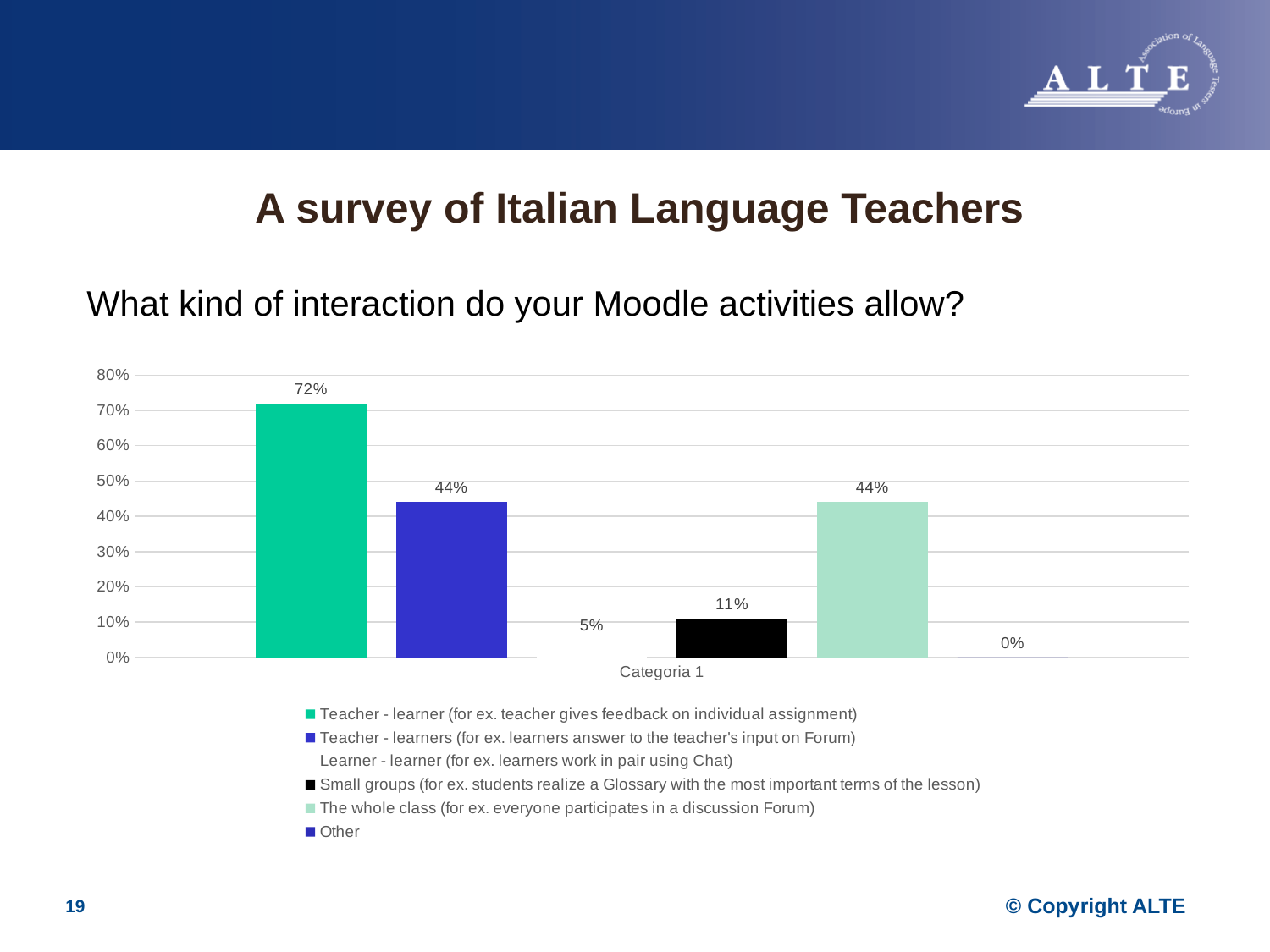
What value is shown for "Small groups"? 11% Which type of interaction has the highest percentage? Teacher - learner What is the difference between the "Teacher - learner" value and the "Teacher - learners" value? 28% What kind of chart is shown on the slide? Bar chart Which type of interaction has the lowest percentage? Other What percentage of teachers selected "Teacher - learner" interaction? 72% What value is shown for "Learner - learner"? 5% What value is shown for "Other"? 0% How many series does the legend list? 6 What is the difference between the "Small groups" value and the "Learner - learner" value? 6% What is the label on the x axis under the bars? Categoria 1 Which is larger, the value for "The whole class" or the value for "Small groups"? The whole class